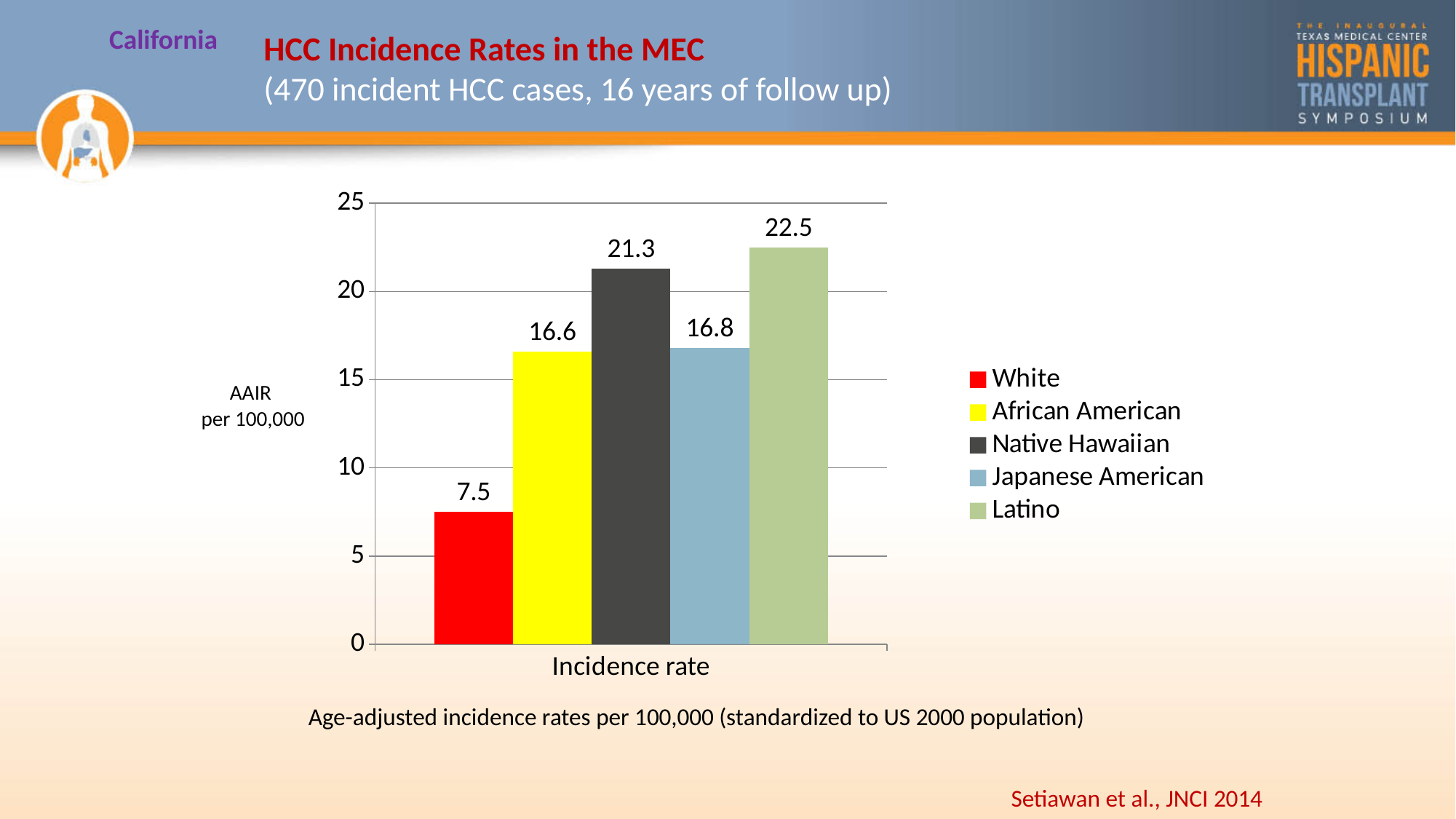
What is the difference between the incidence rates for Latino and White? 15 Which group has the lowest incidence rate in the chart? White What is the incidence rate for Latino in the chart? 22.5 Which group has the highest incidence rate in the chart? Latino What colour is the bar for African American? yellow Is the incidence rate for African American greater or less than 15? greater What is the difference between the incidence rates for Native Hawaiian and African American? 4.7 Which has a higher incidence rate, Native Hawaiian or Japanese American? Native Hawaiian How many series does the legend list? 5 What is the incidence rate for Native Hawaiian in the chart? 21.3 What is the incidence rate for White in the chart? 7.5 What kind of chart is shown on the slide? bar chart